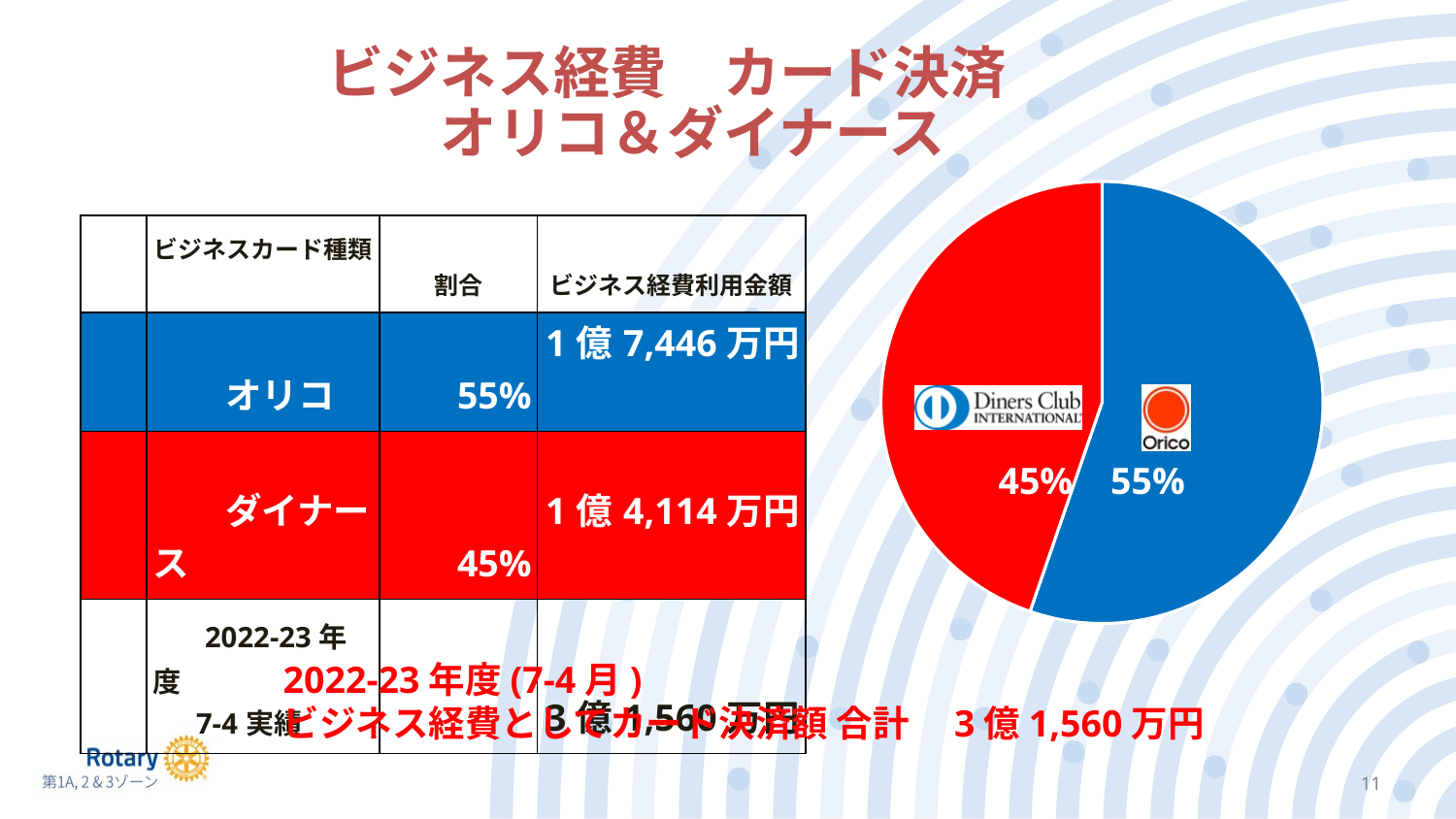
What colour is the Diners Club slice in the pie chart? red What colour is the Orico slice in the pie chart? blue Which slice of the pie chart is the largest? Orico (オリコ) What kind of chart is shown on the slide? pie chart How many slices does the pie chart have? 2 What share of the pie chart does Diners Club (ダイナース) have? 45% Is the share of the Diners Club slice greater or less than 50%? less What share of the pie chart does Orico (オリコ) have? 55% Which is larger in the pie chart, the Orico slice or the Diners Club slice? Orico What is the difference in percentage points between the Orico slice and the Diners Club slice? 10 percentage points Which slice of the pie chart is the smallest? Diners Club (ダイナース) Is the share of the Orico slice greater or less than 50%? greater